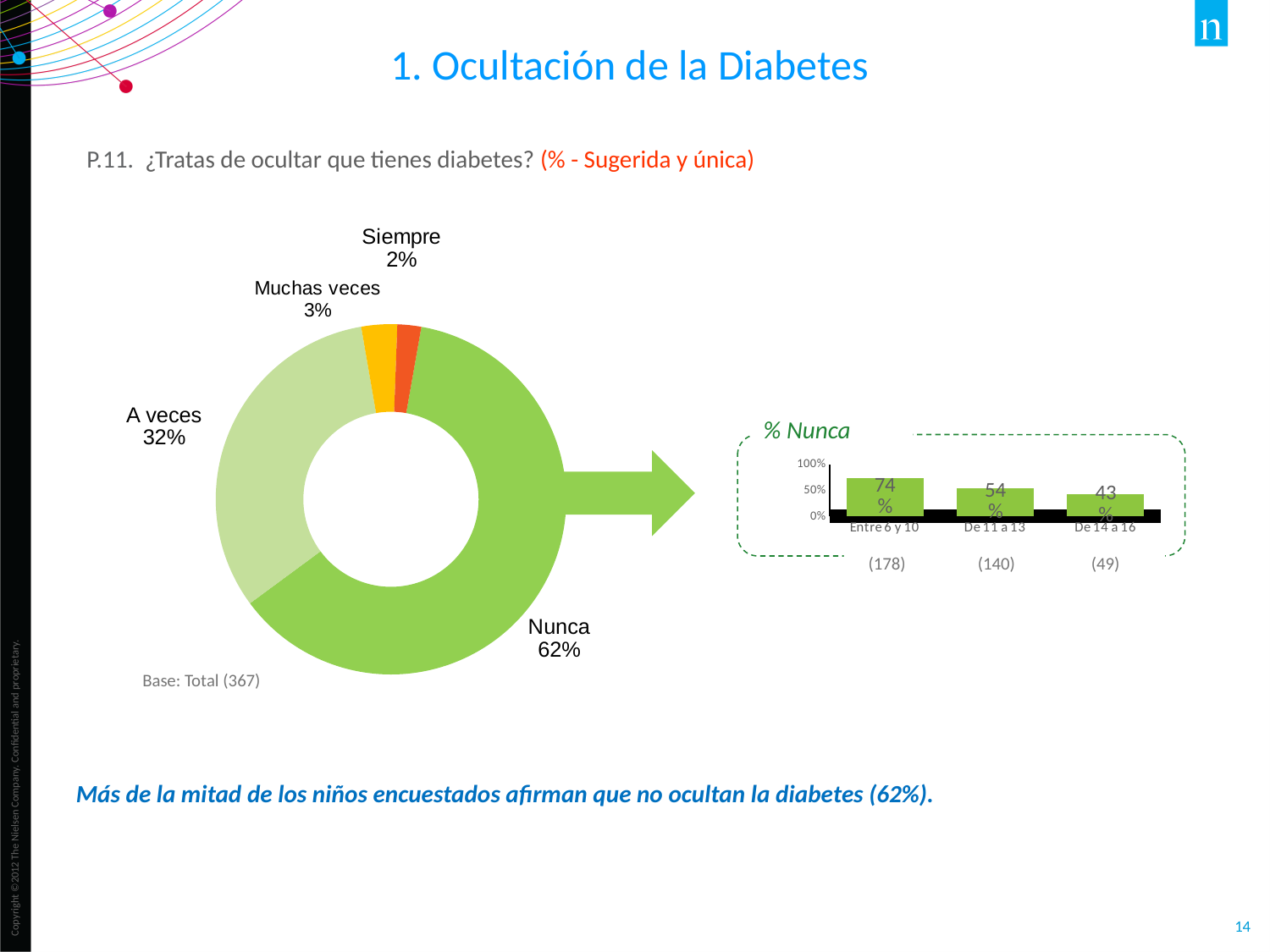
In the donut chart on the left, which category has the largest share? Nunca In the "% Nunca" bar chart on the right, which age group has the lowest value? De 14 a 16 What kind of chart is shown on the right side of the slide under the "% Nunca" label? bar chart In the donut chart on the left, what percentage of respondents answered "Nunca"? 62% In the "% Nunca" bar chart on the right, what is the value for the "De 14 a 16" age group? 43% In the donut chart on the left, which category has the smallest share? Siempre In the "% Nunca" bar chart on the right, what is the value for the "Entre 6 y 10" age group? 74% In the donut chart on the left, what percentage of respondents answered "Siempre"? 2% In the donut chart on the left, what is the difference in percentage points between "Nunca" and "A veces"? 30 In the "% Nunca" bar chart on the right, do the values rise or fall as the age groups get older from left to right? fall In the donut chart on the left, what percentage of respondents answered "A veces"? 32% In the donut chart on the left, how many categories are shown? 4